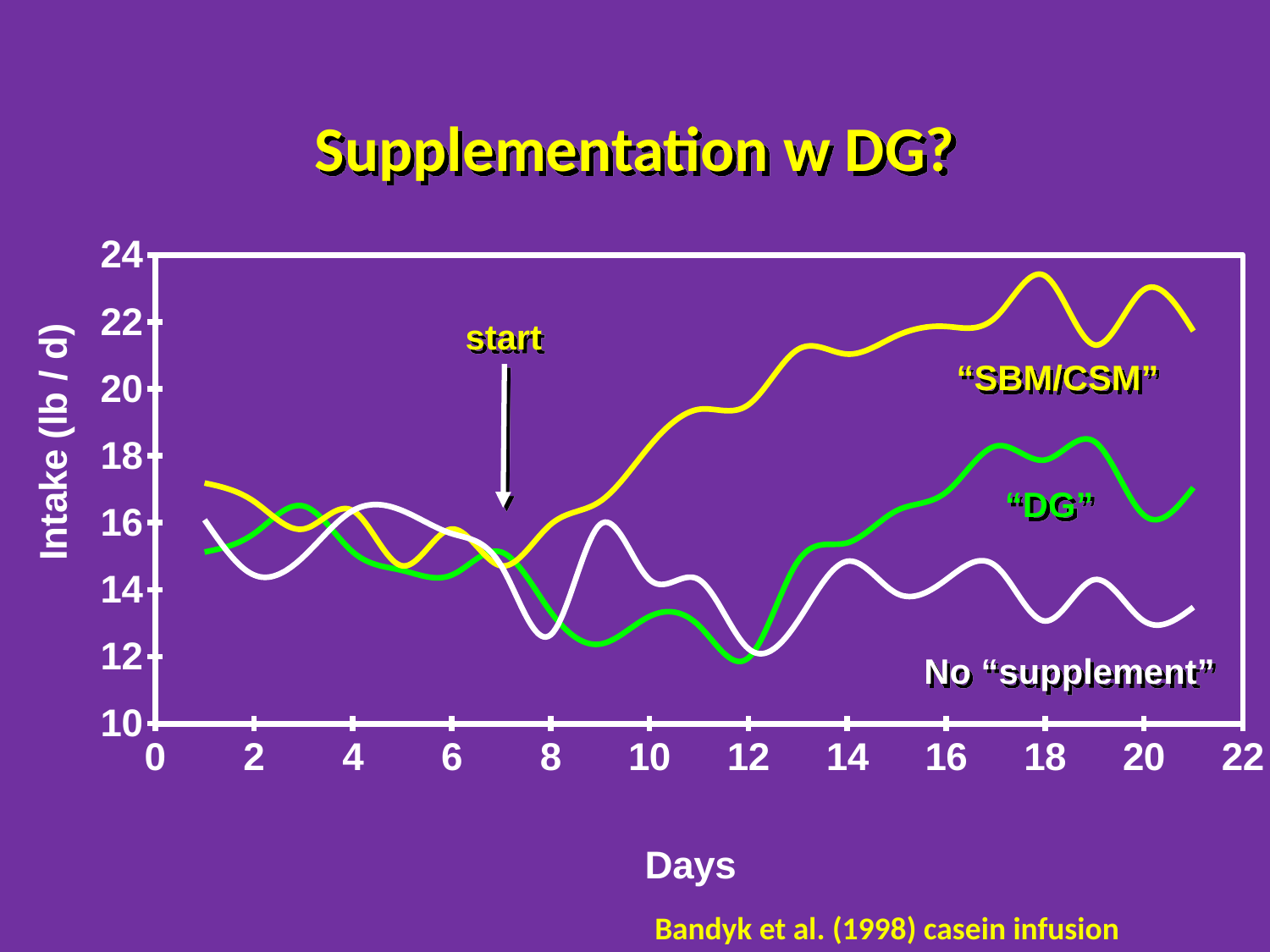
What is the title of the y axis? Intake (lb / d) Is the intake for "DG" at day 12 greater or less than 14? less Is the intake for "SBM/CSM" at day 14 greater or less than 20? greater Which series has the lowest intake at day 21? No "supplement" At day 16, which series has the higher intake, "DG" or No "supplement"? "DG" What kind of chart is shown on the slide? line chart Does the intake for "SBM/CSM" rise or fall from day 8 to day 18? rise At day 20, which series has the higher intake, "SBM/CSM" or "DG"? "SBM/CSM" Is the intake for "SBM/CSM" at day 18 greater or less than 22? greater How many data series are plotted on the chart? 3 Which series has the highest intake at day 21? "SBM/CSM"